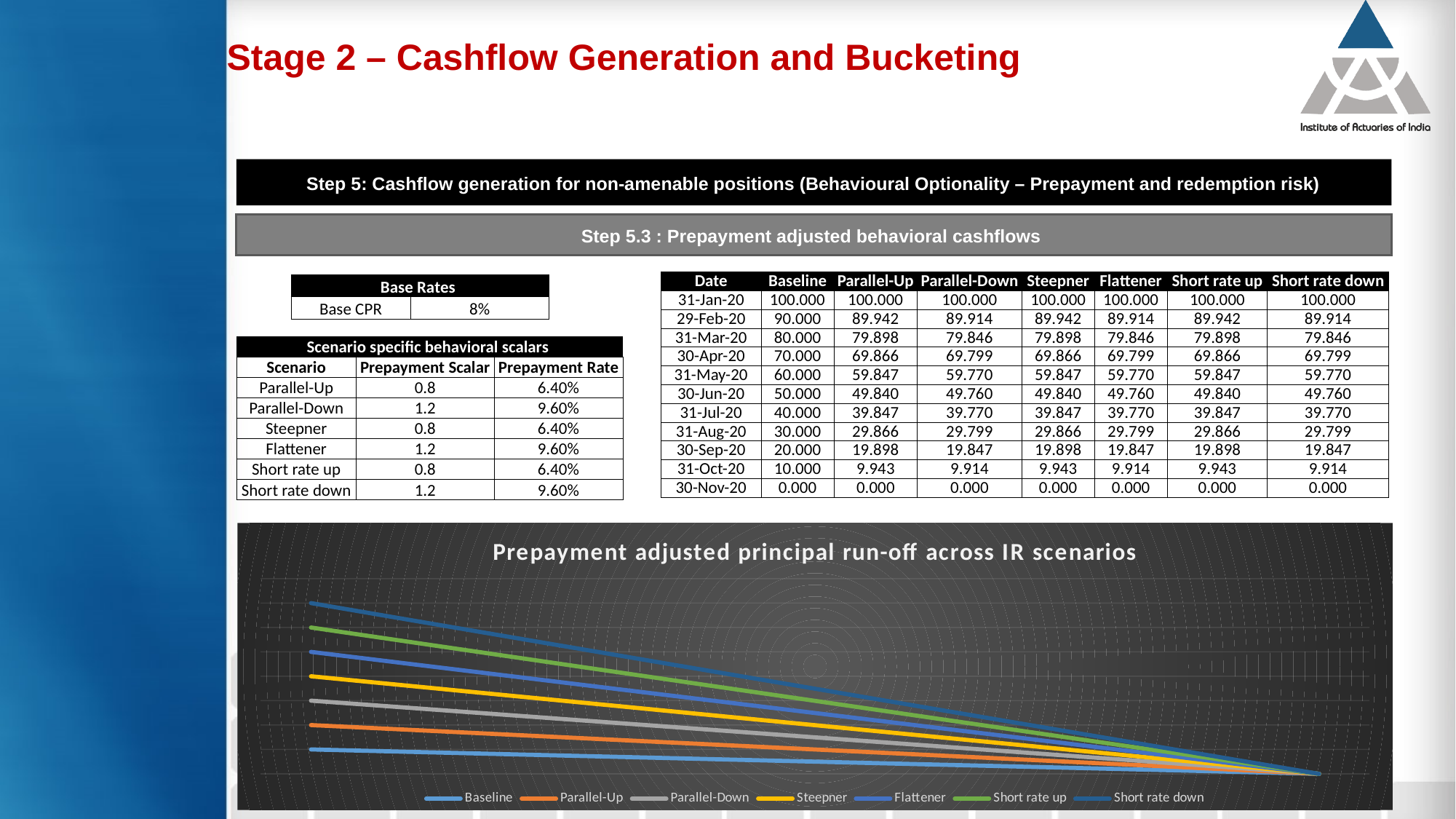
Which series in the chart is drawn in green? Short rate up What kind of chart is shown at the bottom of the slide? line chart How many series does the legend of the chart list? 7 What is the title of the chart? Prepayment adjusted principal run-off across IR scenarios Do the lines in the chart rise or fall from left to right? fall